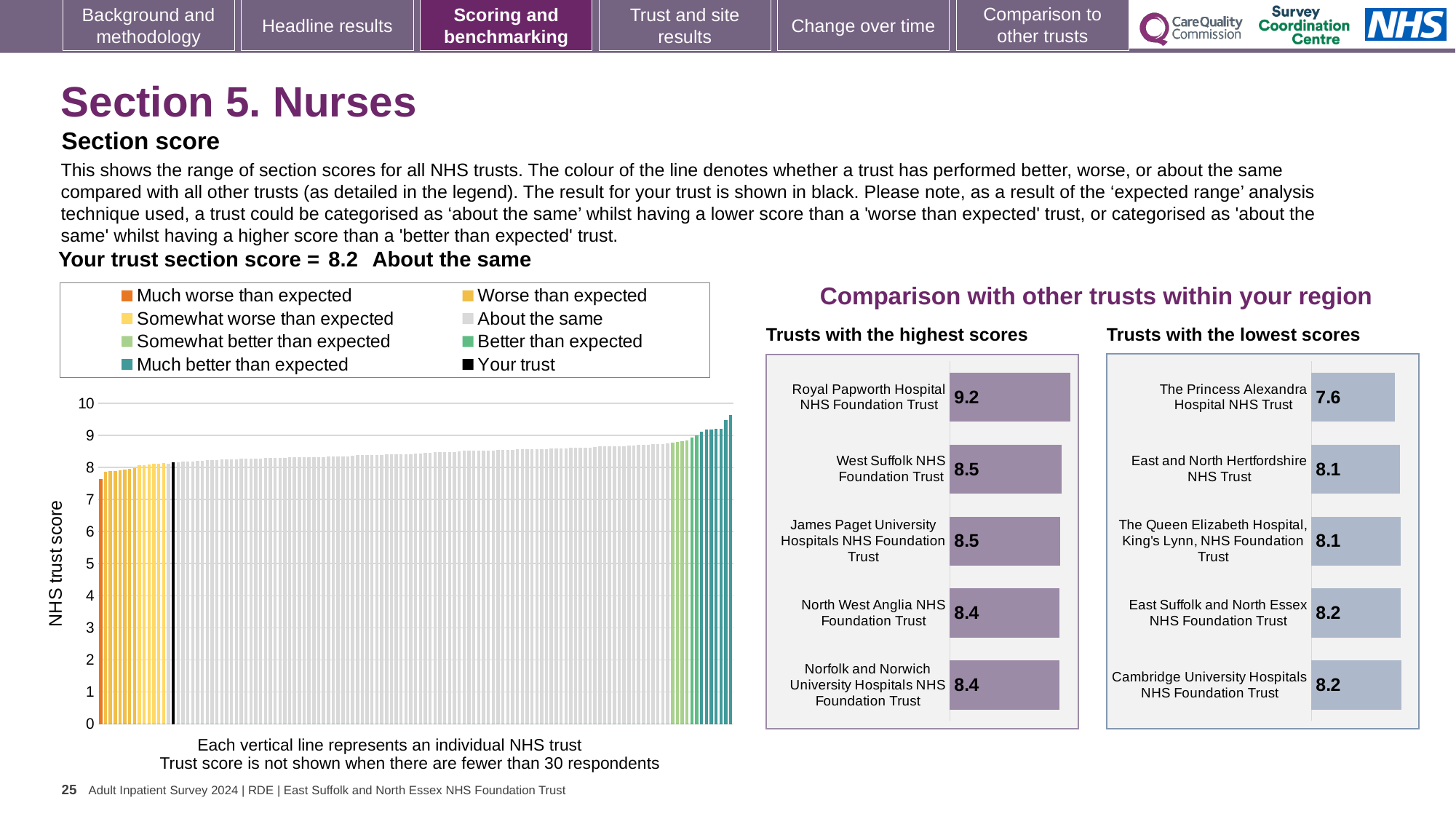
What kind of chart is the large chart on the left showing the range of section scores for all NHS trusts? Bar chart In the 'Trusts with the highest scores' chart, what is the difference between the scores of Royal Papworth Hospital NHS Foundation Trust and West Suffolk NHS Foundation Trust? 0.7 How many entries does the legend of the large chart on the left list? 8 In the 'Trusts with the highest scores' chart, how many trusts are shown? 5 In the large chart on the left, do the trust scores rise or fall from left to right? Rise In the 'Trusts with the lowest scores' chart, what is the score for The Princess Alexandra Hospital NHS Trust? 7.6 In the 'Trusts with the highest scores' chart, what is the score for Royal Papworth Hospital NHS Foundation Trust? 9.2 In the 'Trusts with the lowest scores' chart, what is the score for Cambridge University Hospitals NHS Foundation Trust? 8.2 In the 'Trusts with the highest scores' chart, which has a higher score: Royal Papworth Hospital NHS Foundation Trust or North West Anglia NHS Foundation Trust? Royal Papworth Hospital NHS Foundation Trust In the 'Trusts with the highest scores' chart, which trust has the highest score? Royal Papworth Hospital NHS Foundation Trust In the 'Trusts with the lowest scores' chart, which trust has the lowest score? The Princess Alexandra Hospital NHS Trust In the 'Trusts with the lowest scores' chart, what is the difference between the scores of East and North Hertfordshire NHS Trust and The Princess Alexandra Hospital NHS Trust? 0.5